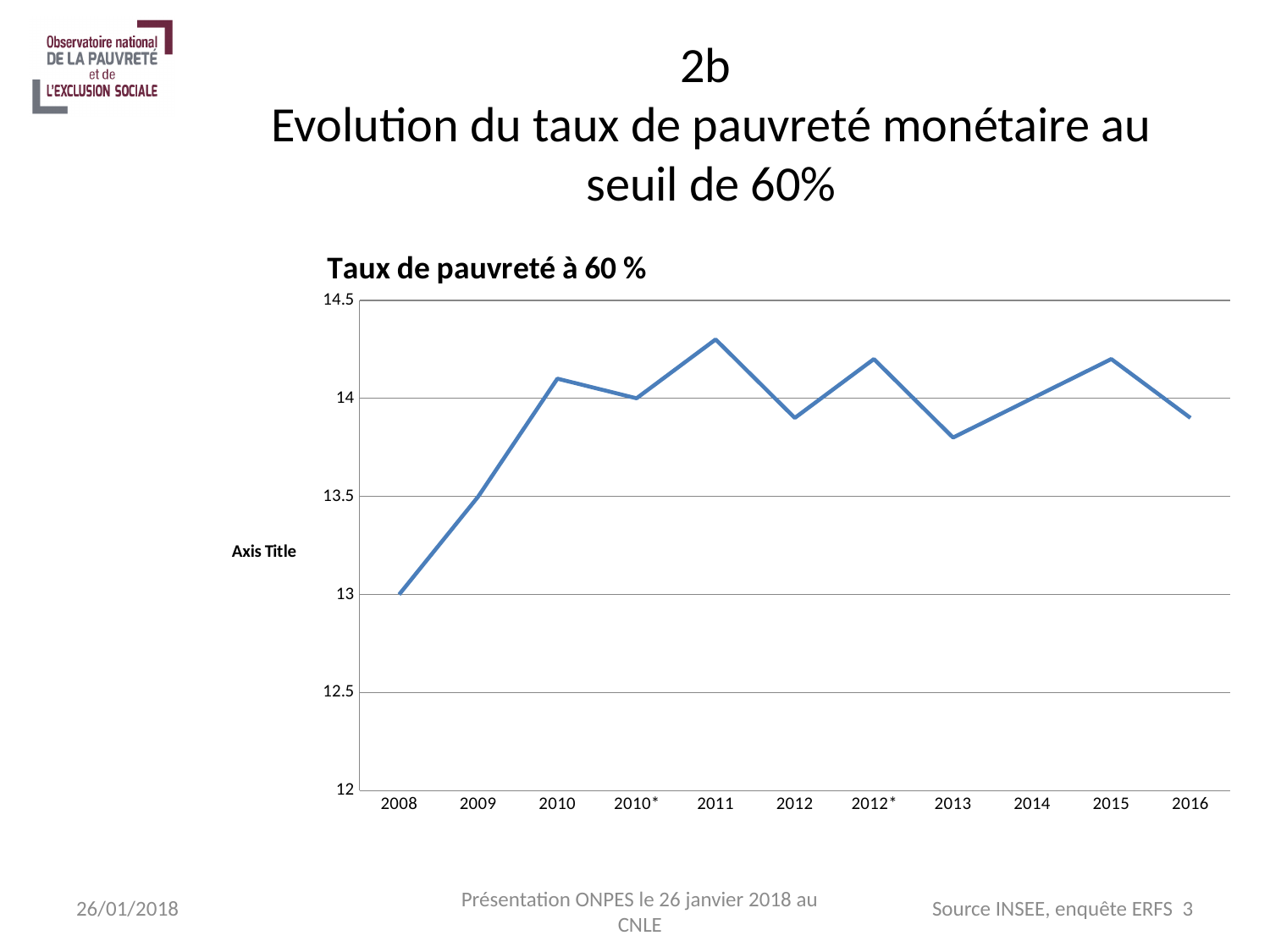
Is the value for 2013 greater or less than 14? less Which year has the lowest value? 2008 What is the value for 2008? 13 Is the value for 2011 greater or less than 14? greater What is the title of the chart? Taux de pauvreté à 60 % Is the value for 2009 greater or less than 14? less What type of chart is shown on the slide? line chart Does the value rise or fall from 2008 to 2010? rise What is the value for 2010*? 14 Which is larger, the value for 2013 or the value for 2015? 2015 How many data points are plotted on the x axis? 11